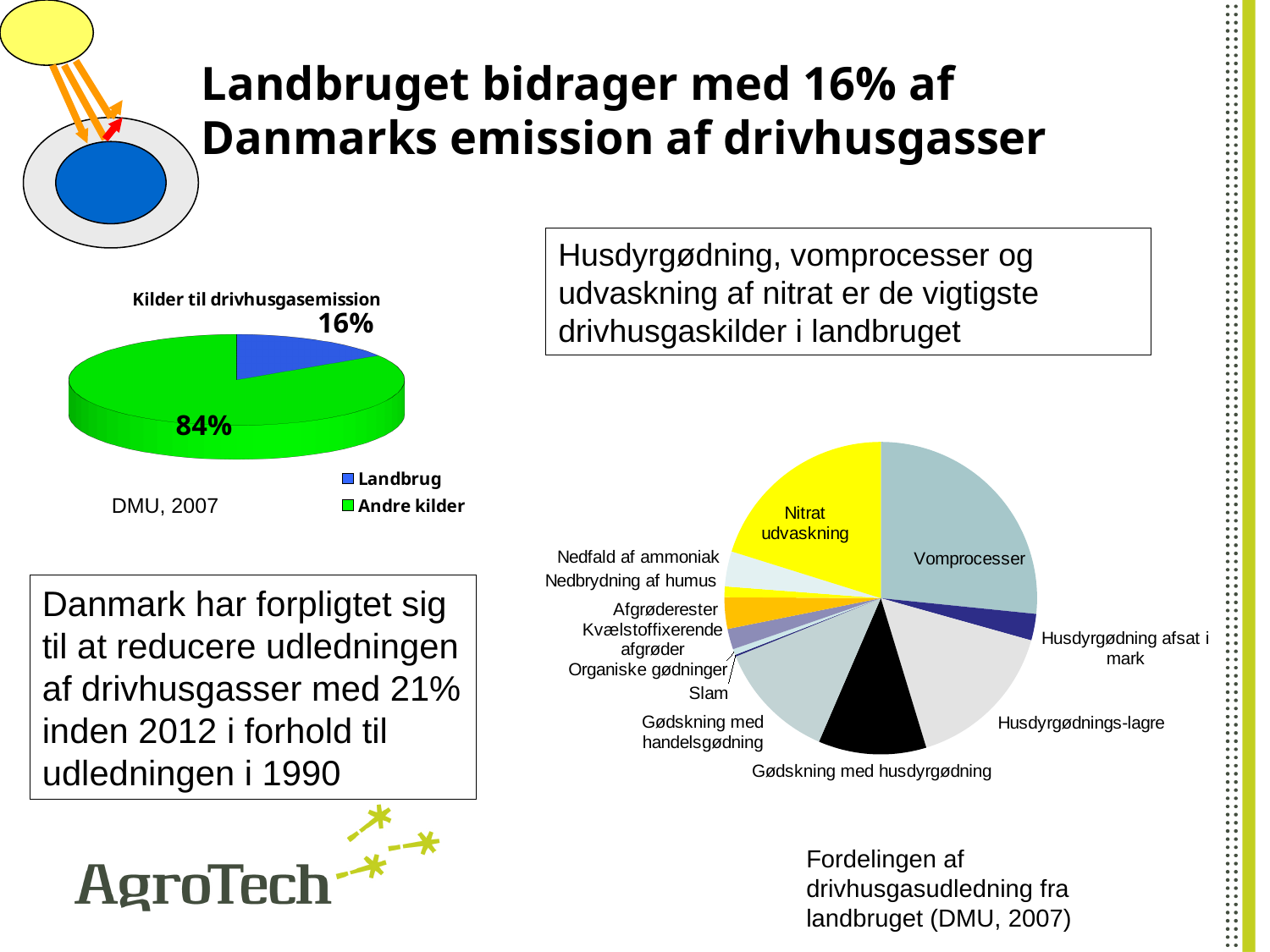
In the chart titled 'Kilder til drivhusgasemission', what percentage is shown for Landbrug? 16% In the pie chart at the bottom right of the slide, which category is shown in black? Gødskning med husdyrgødning In the chart titled 'Kilder til drivhusgasemission', what is the difference in percentage points between Andre kilder and Landbrug? 68 In the chart titled 'Kilder til drivhusgasemission', what colour is the Landbrug slice? Blue In the pie chart at the bottom right of the slide, which slice is larger: Nitrat udvaskning or Husdyrgødning afsat i mark? Nitrat udvaskning In the chart titled 'Kilder til drivhusgasemission', how many entries does the legend list? 2 In the chart titled 'Kilder til drivhusgasemission', what percentage is shown for Andre kilder? 84% What kind of chart is the chart titled 'Kilder til drivhusgasemission'? Pie chart In the pie chart at the bottom right of the slide, how many slices are there? 12 In the pie chart at the bottom right of the slide, which category has the largest slice? Vomprocesser What kind of chart is the chart at the bottom right of the slide showing the distribution of greenhouse gas emissions from agriculture? Pie chart In the chart titled 'Kilder til drivhusgasemission', which category has the largest share? Andre kilder